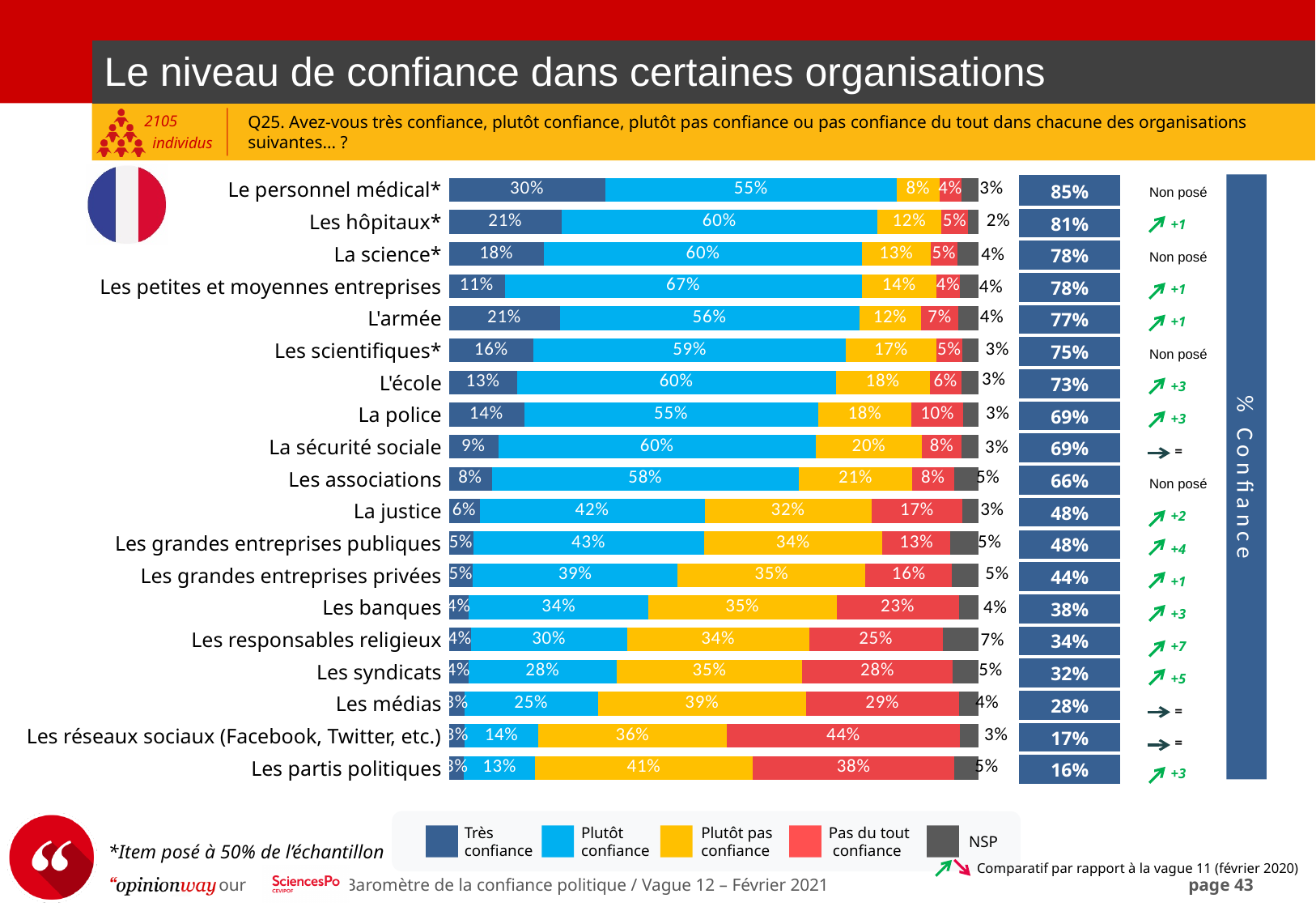
What is the difference in % Confiance between Les hôpitaux* and La police? 12 percentage points What is the "Très confiance" value for Le personnel médical*? 30% What is the "Pas du tout confiance" value for Les réseaux sociaux (Facebook, Twitter, etc.)? 44% What kind of chart is shown on the slide? Stacked bar chart Which organisation has the lowest % Confiance? Les partis politiques Which has a higher "Plutôt pas confiance" value, Les médias or Les banques? Les médias What is the NSP value for Les responsables religieux? 7% What is the combined total of "Très confiance" and "Plutôt confiance" for L'école? 73% How many organisations are listed in the chart? 19 What percentage of respondents answered "Plutôt confiance" for Les petites et moyennes entreprises? 67% How many series does the legend list? 5 Which organisation has the highest % Confiance? Le personnel médical*